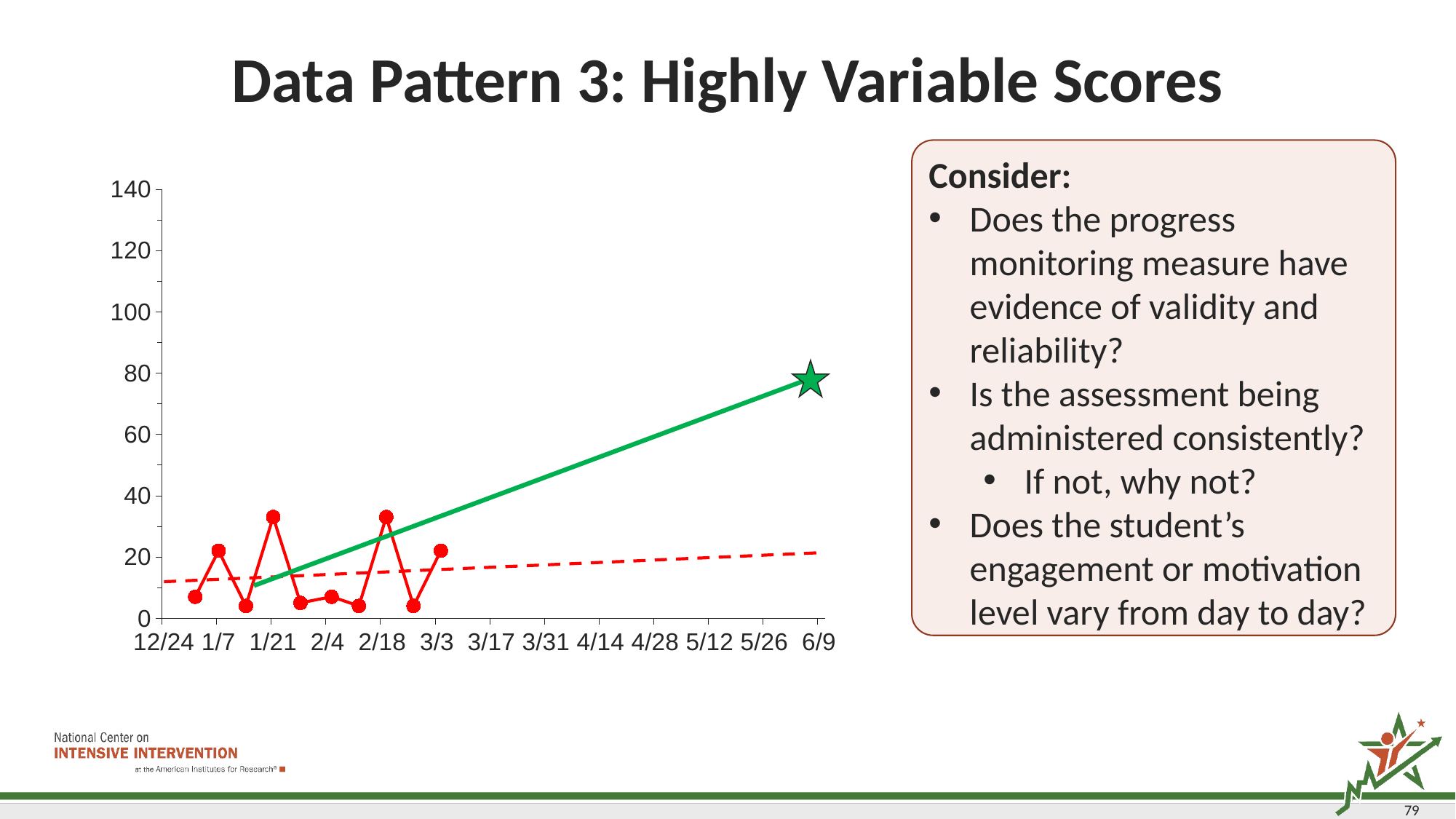
Is the value at the green star on 6/9 greater or less than 60? greater How many red data points are plotted on the chart? 10 Is the value at the green star on 6/9 greater or less than 100? less Which is larger, the value for 1/7 or the value for 2/4? 1/7 Is the value for 2/4 greater or less than 20? less Does the red dashed trend line rise or fall from left to right? rise Which is larger, the value for 1/21 or the value for 2/4? 1/21 What symbol marks the end of the green goal line on 6/9? a green star What kind of chart is shown on the slide? line chart What is the highest value shown on the y axis? 140